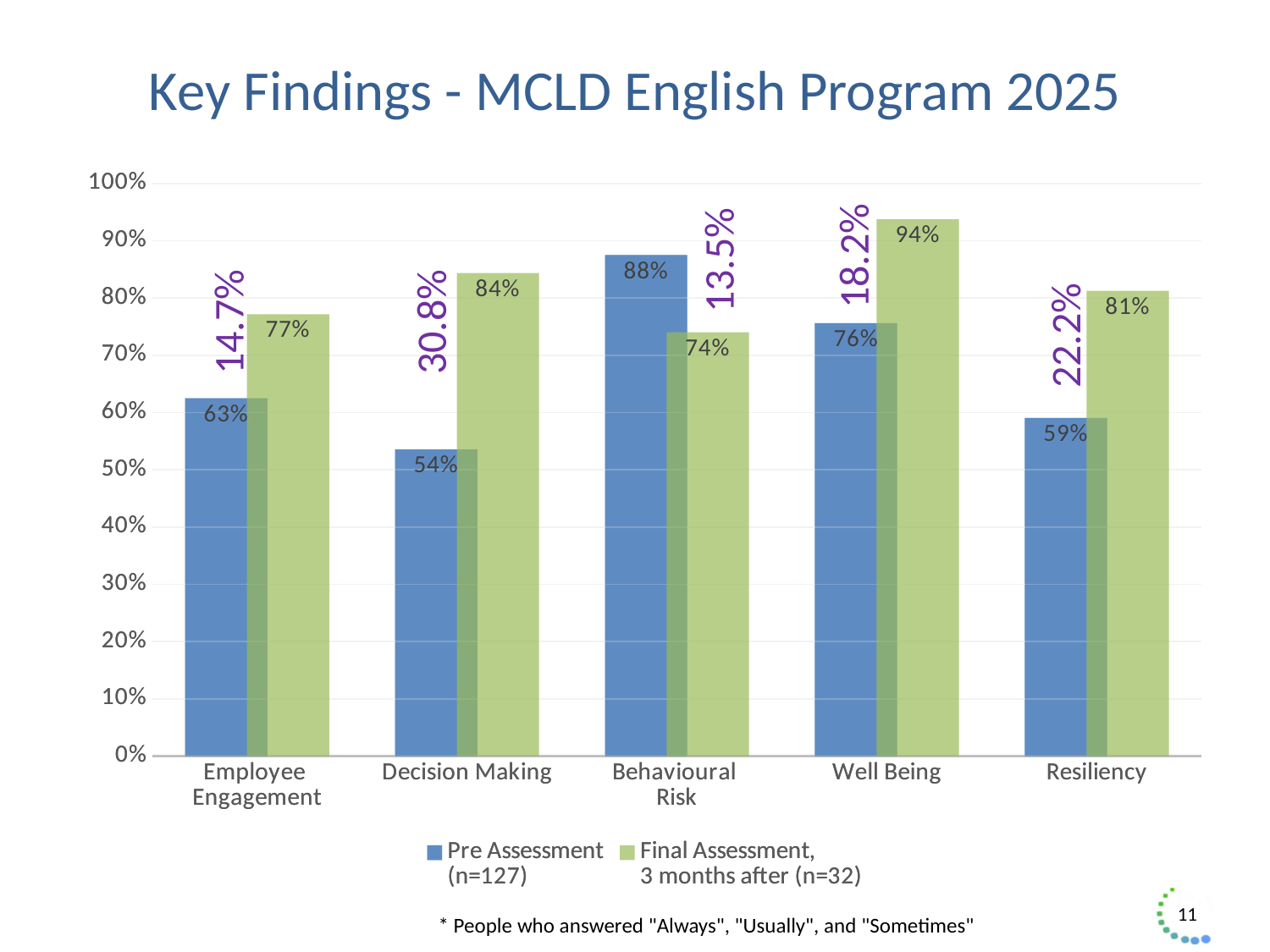
Which category has the highest Final Assessment value? Well Being What is the Pre Assessment value for Behavioural Risk? 88% How many categories are shown on the x axis? 5 What kind of chart is shown on the slide? Bar chart What is the purple percentage annotation shown above the Well Being bars? 18.2% What is the Final Assessment value for Well Being? 94% What is the Pre Assessment value for Decision Making? 54% For Behavioural Risk, which is larger: the Pre Assessment value or the Final Assessment value? Pre Assessment How many series does the legend list? 2 Is the Final Assessment value for Resiliency greater or less than 80%? greater Which category has the lowest Pre Assessment value? Decision Making What is the difference between the Final Assessment and Pre Assessment values for Decision Making? 30%